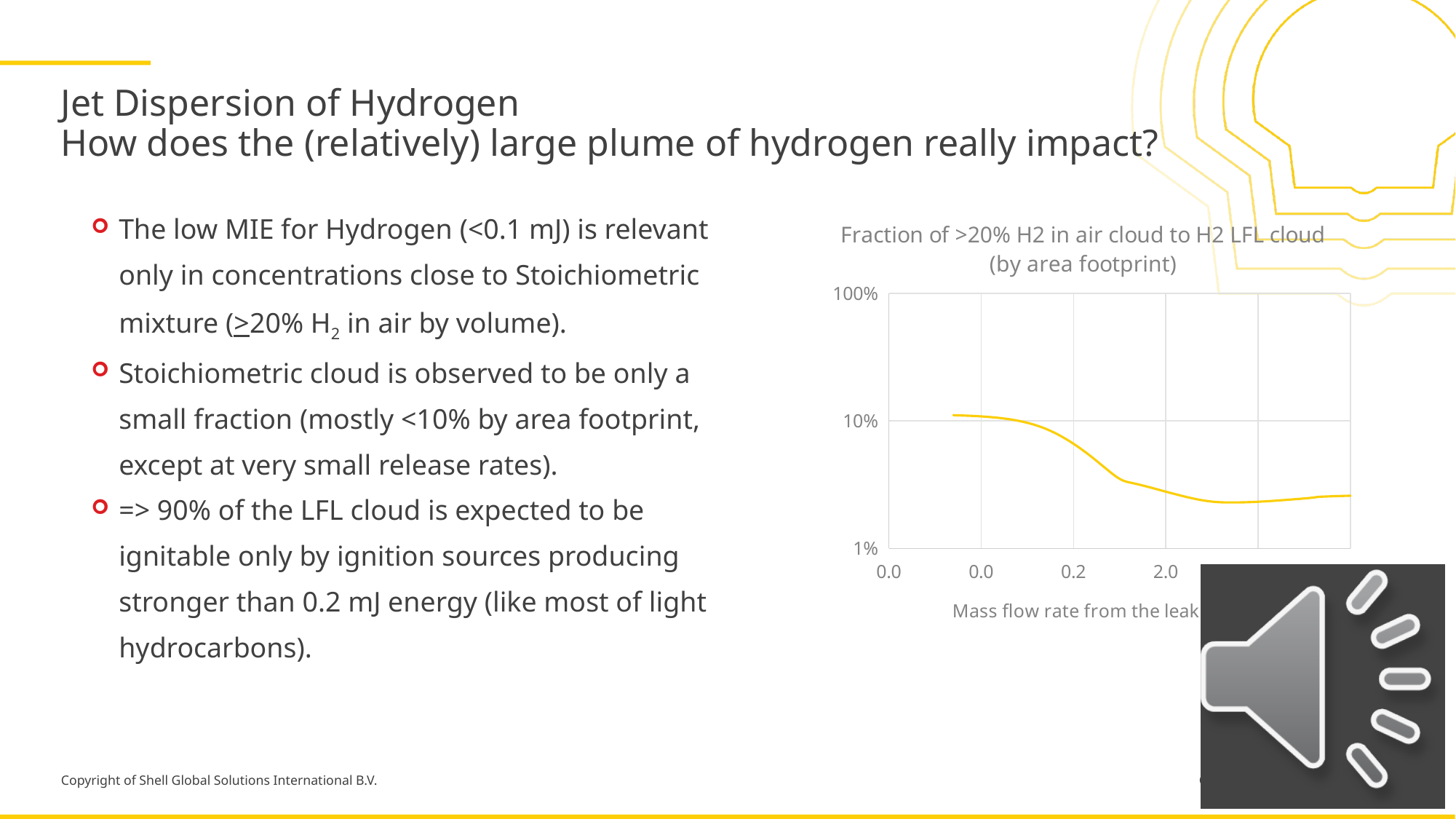
What is the title of the chart? Fraction of >20% H2 in air cloud to H2 LFL cloud (by area footprint) Is the value of the line at the x-axis tick labelled 0.2 greater or less than 10%? less Is the value of the line at the x-axis tick labelled 2.0 greater or less than 10%? less Is the value of the line at its left-hand end greater or less than 100%? less Does the plotted line rise or fall as the mass flow rate increases along the x axis? fall What is the highest tick label shown on the y axis? 100% What kind of chart is shown on the slide? line chart How many lines (series) are plotted on the chart? 1